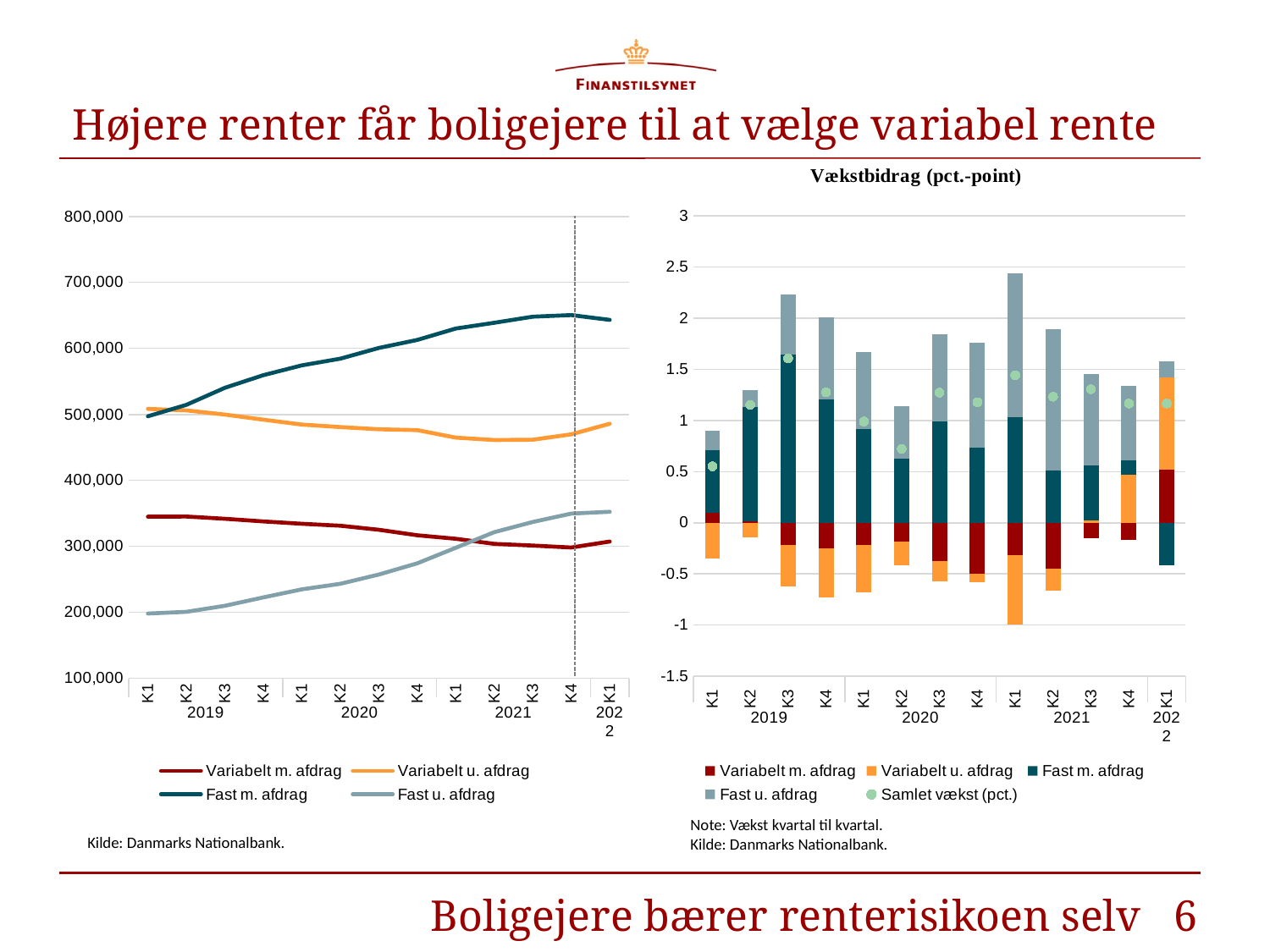
What is the title of the chart on the right? Vækstbidrag (pct.-point) How many series does the legend of the left chart list? 4 How many quarters are shown on the x axis of the left chart? 13 In the left chart, which series has the lowest value at K1 2019? Fast u. afdrag In the left chart, which series has the highest value at K1 2022? Fast m. afdrag What kind of chart is the chart on the right titled 'Vækstbidrag (pct.-point)'? bar chart How many entries does the legend of the right chart 'Vækstbidrag (pct.-point)' list? 5 In the left chart, is the value for Fast u. afdrag at K1 2019 greater or less than 300,000? less In the left chart, does the Fast u. afdrag series rise or fall from K1 2019 to K1 2022? rise In the left chart, is the value for Fast m. afdrag at K1 2022 greater or less than 600,000? greater In the right chart 'Vækstbidrag (pct.-point)', is the Variabelt u. afdrag contribution in K1 2021 greater or less than -0.5? less In the right chart 'Vækstbidrag (pct.-point)', in which quarter is the Samlet vækst (pct.) marker highest? K3 2019